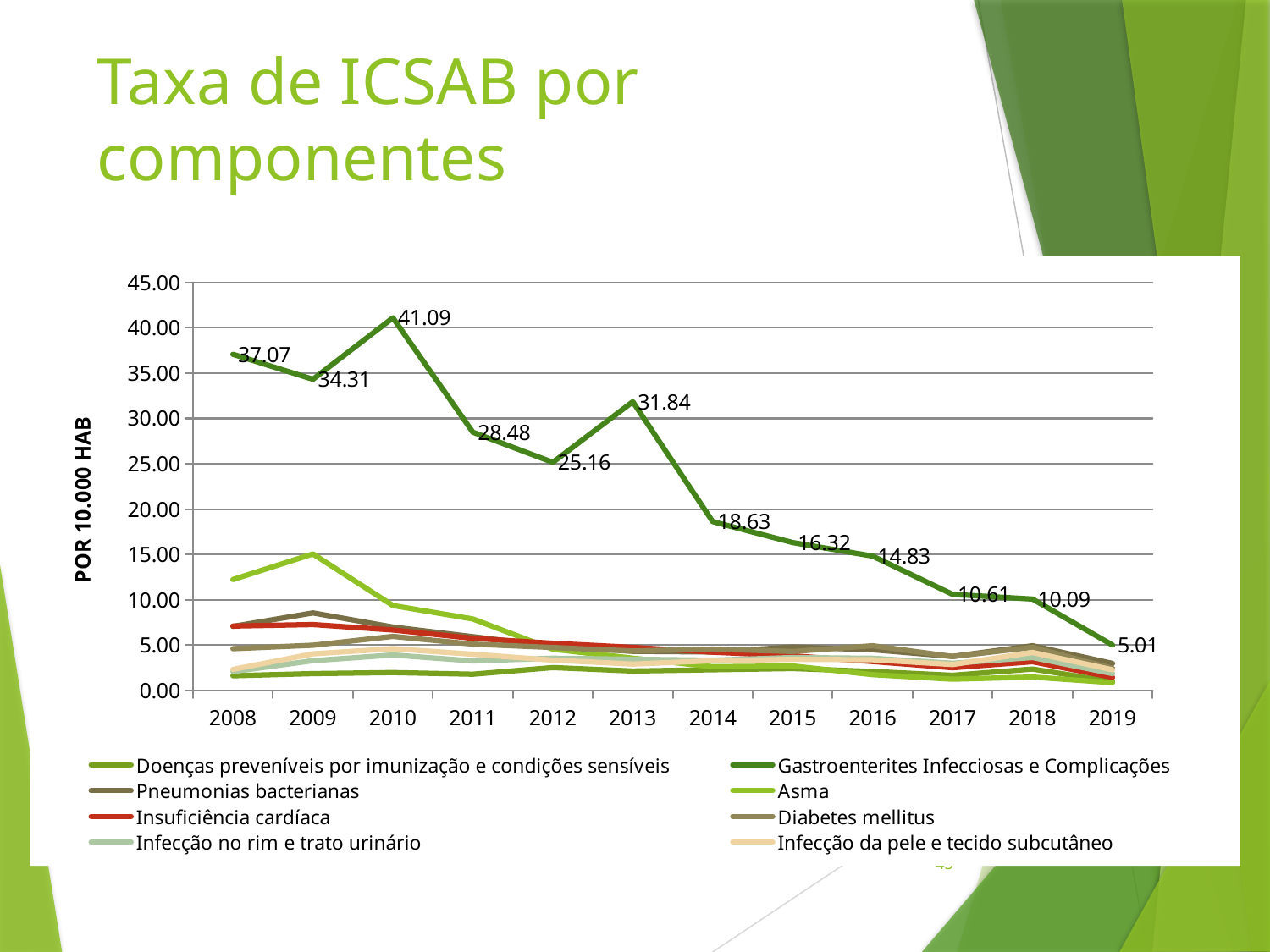
Overall, does the Gastroenterites Infecciosas e Complicações series rise or fall from 2008 to 2019? fall Is the value for Asma in 2009 greater or less than 10.00? greater In which year does the Gastroenterites Infecciosas e Complicações series reach its highest value? 2010 What is the value for Gastroenterites Infecciosas e Complicações in 2013? 31.84 How many years are shown on the x axis? 12 How many series does the legend list? 8 What type of chart is shown on the slide? line chart What is the difference between the Gastroenterites Infecciosas e Complicações values in 2008 and 2009? 2.76 In which year does the Gastroenterites Infecciosas e Complicações series reach its lowest value? 2019 What is the value for Gastroenterites Infecciosas e Complicações in 2010? 41.09 What is the value for Gastroenterites Infecciosas e Complicações in 2019? 5.01 Which is larger for Gastroenterites Infecciosas e Complicações: the value in 2011 or the value in 2012? 2011